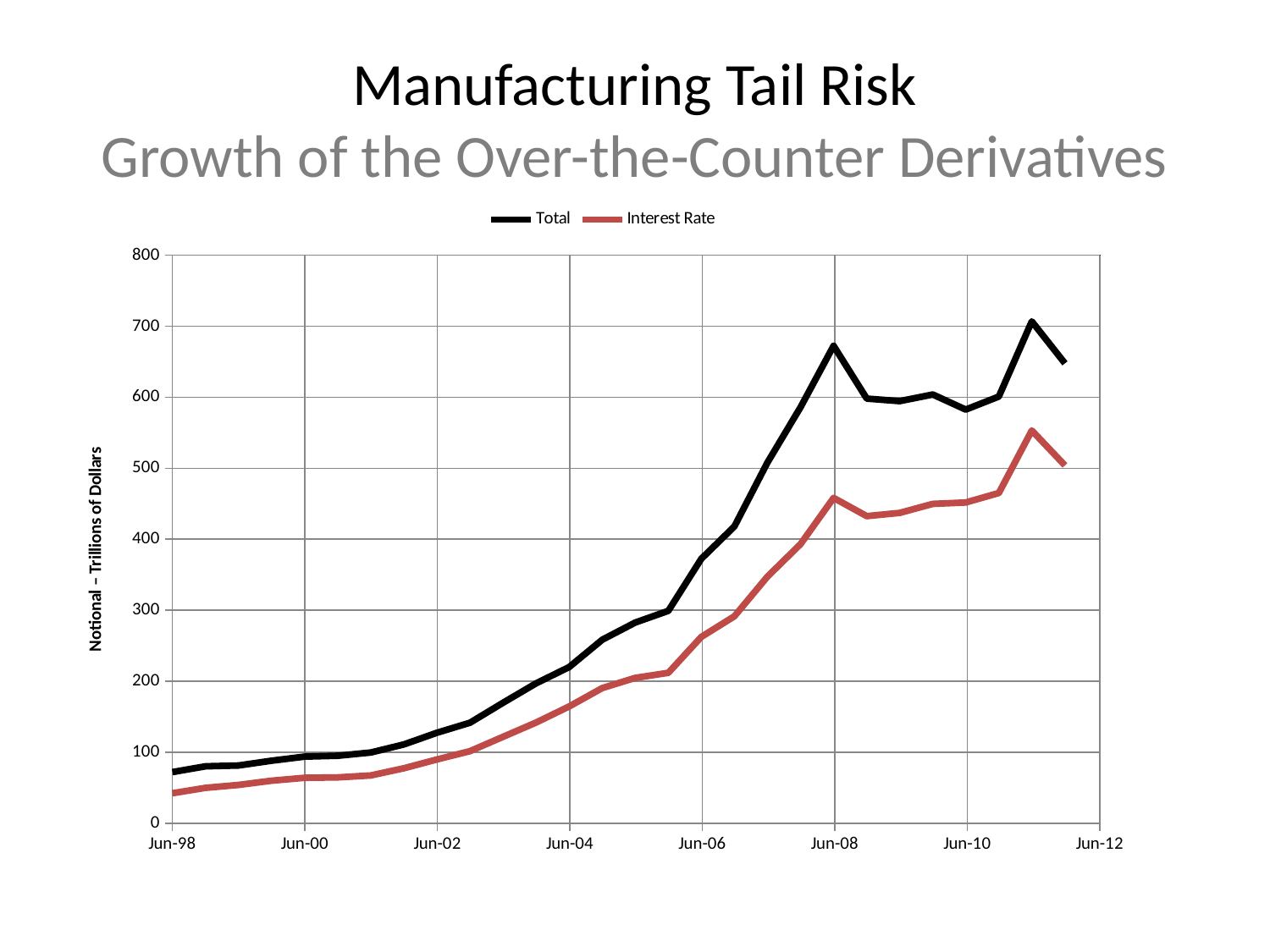
Is the value of the Total series at Jun-06 greater or less than 300? greater Does the Total series generally rise or fall from Jun-98 to Jun-08? rise At Jun-08, which series has the larger value, Total or Interest Rate? Total How many series does the legend list? 2 Is the value of the Total series at Jun-08 greater or less than 600? greater What is the label on the vertical axis? Notional – Trillions of Dollars What kind of chart is shown on the slide? line chart Is the value of the Total series at Jun-98 greater or less than 100? less How many date labels are shown on the x axis? 8 What are the two series named in the legend? Total and Interest Rate